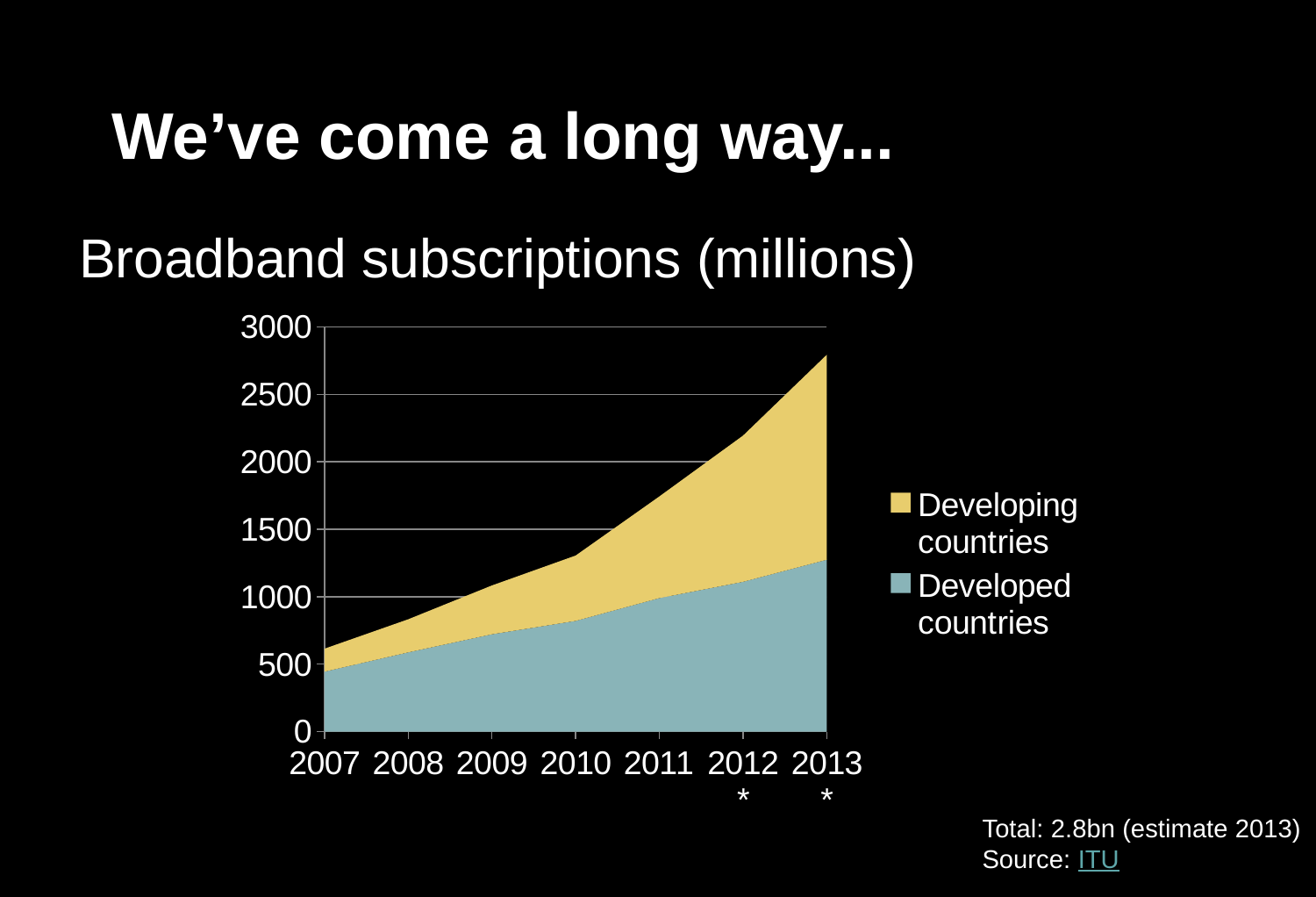
Is the total of broadband subscriptions in 2010 greater or less than 1500? less How many series does the legend list? 2 According to the note on the slide, what is the estimated total for 2013? 2.8bn How many years are shown on the x axis? 7 What kind of chart is shown on the slide? Stacked area chart Which colour represents Developing countries in the chart? Yellow In which year is the total of broadband subscriptions highest? 2013 Do total broadband subscriptions rise or fall from 2007 to 2013? Rise Is the total of broadband subscriptions in 2013 greater or less than 2500? greater In which year is the total of broadband subscriptions lowest? 2007 Is the value for Developed countries in 2013 greater or less than 1000? greater